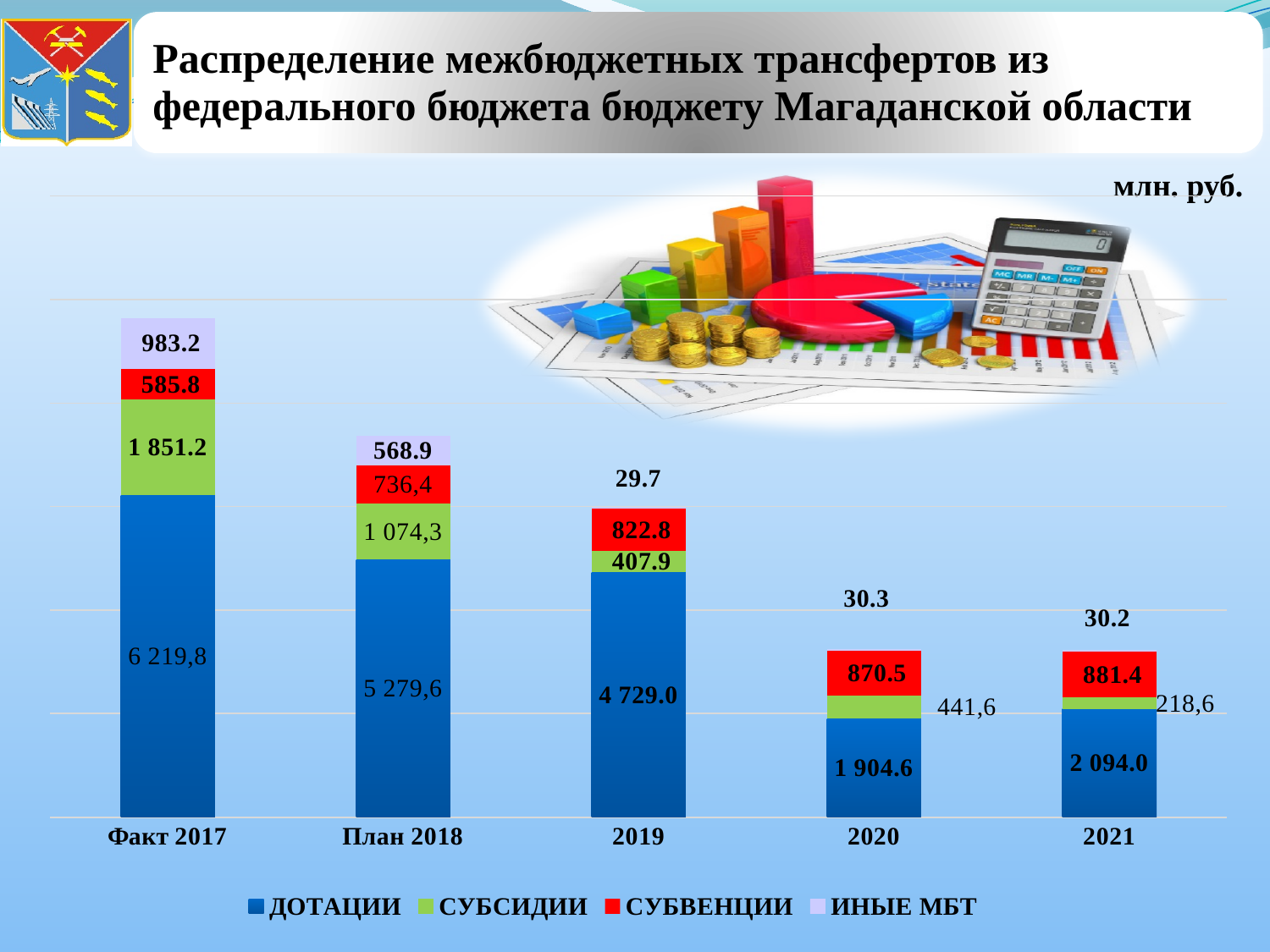
What is the value of ДОТАЦИИ for Факт 2017? 6 219,8 What is the value of СУБСИДИИ for 2021? 218,6 Which category has the highest value for ДОТАЦИИ? Факт 2017 What is the value of ИНЫЕ МБТ for План 2018? 568.9 What is the value of СУБВЕНЦИИ for 2020? 870.5 What is the difference between the СУБВЕНЦИИ values for 2021 and 2020? 10.9 How many categories are shown on the x axis? 5 Which category has the lowest value for ДОТАЦИИ? 2020 Do the СУБВЕНЦИИ values rise or fall from Факт 2017 to 2021? Rise Which is larger: СУБСИДИИ for 2019 or СУБСИДИИ for 2020? 2020 How many series does the legend list? 4 What kind of chart is shown on the slide? Stacked bar chart